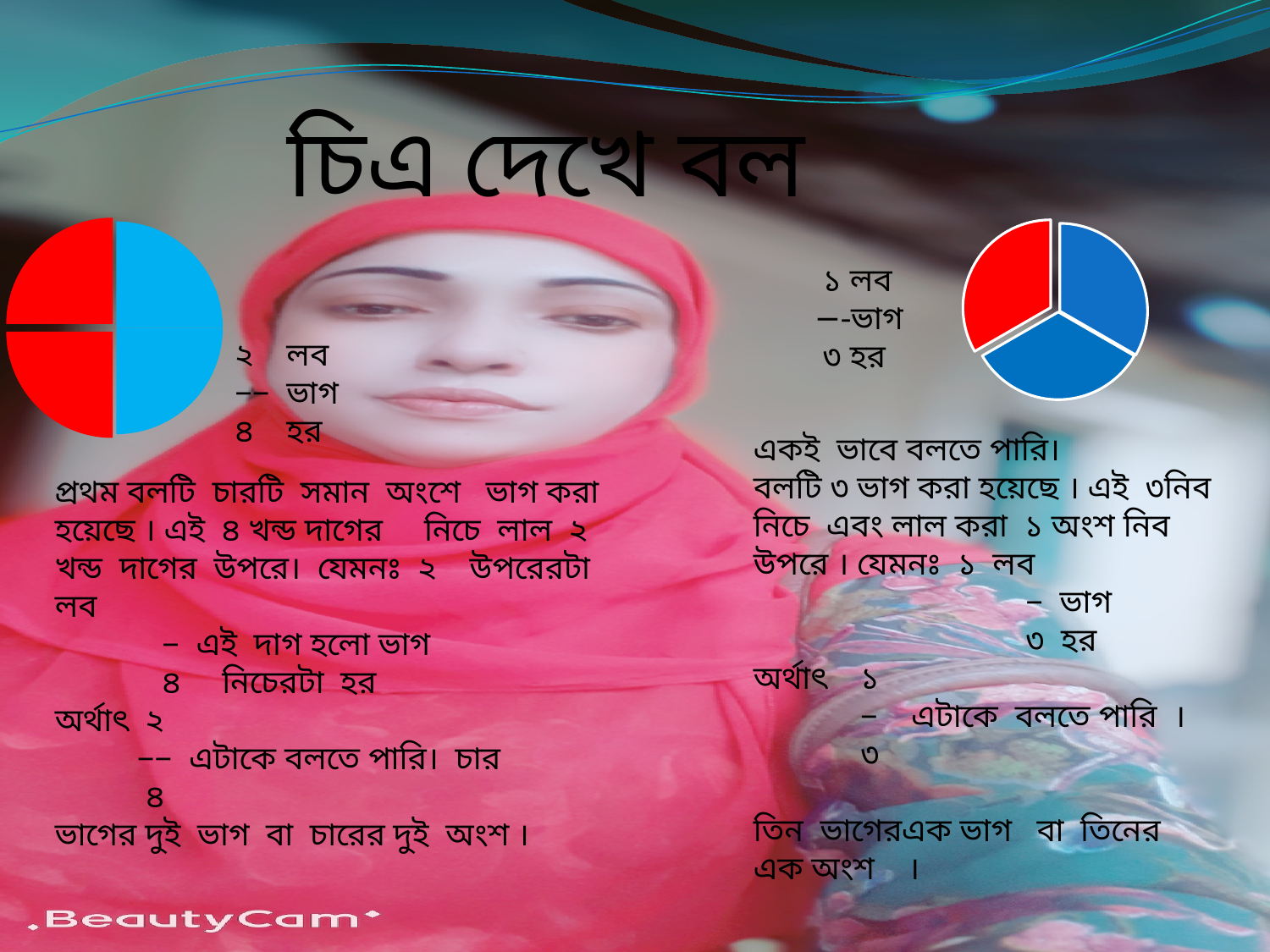
In the pie chart on the right side of the slide, how many slices are there? 3 According to the slide text, into how many parts is the right pie chart divided? ৩ According to the slide text, into how many equal parts is the left pie chart divided? ৪ What is the title of the slide containing the two pie charts? চিএ দেখে বল In the pie chart on the right side of the slide, how many slices are red? 1 What kind of chart is the chart on the left side of the slide? pie chart According to the slide, what fraction of the left pie chart do the red slices represent? ২/৪ According to the slide, what fraction of the right pie chart does the red slice represent? ১/৩ What kind of chart is the chart on the right side of the slide? pie chart In the pie chart on the left side of the slide, how many slices are red? 2